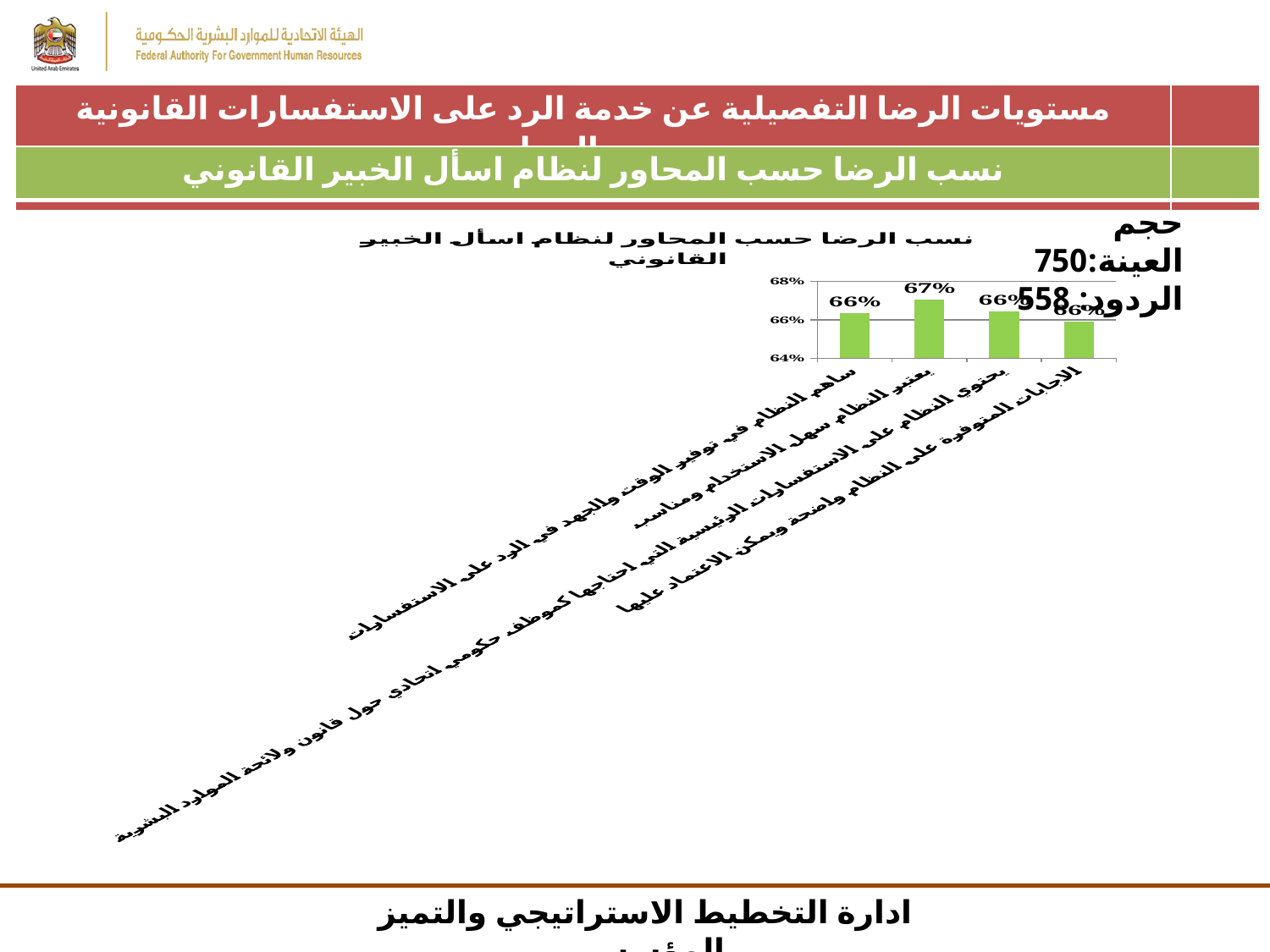
What is the value for "ساهم النظام في توفير الوقت والجهد في الرد على الاستفسارات"? 66% What is the value for "يعتبر النظام سهل الاستخدام ومناسب"? 67% What is the value for "الإجابات المتوفرة على النظام واضحة ويمكن الاعتماد عليها"? 66% What is the difference between the value for "يعتبر النظام سهل الاستخدام ومناسب" and the value for "ساهم النظام في توفير الوقت والجهد في الرد على الاستفسارات"? 1% Is the value for "يعتبر النظام سهل الاستخدام ومناسب" greater or less than 66%? greater What type of chart is shown on the slide? bar chart What is the title of the chart? نسب الرضا حسب المحاور لنظام اسأل الخبير القانوني Which category has the highest value in the chart? يعتبر النظام سهل الاستخدام ومناسب Is the value for "ساهم النظام في توفير الوقت والجهد في الرد على الاستفسارات" greater or less than 64%? greater How many bars (categories) does the chart show? 4 Which is larger: the value for "يعتبر النظام سهل الاستخدام ومناسب" or the value for "الإجابات المتوفرة على النظام واضحة ويمكن الاعتماد عليها"? يعتبر النظام سهل الاستخدام ومناسب What colour are the bars in the chart? green